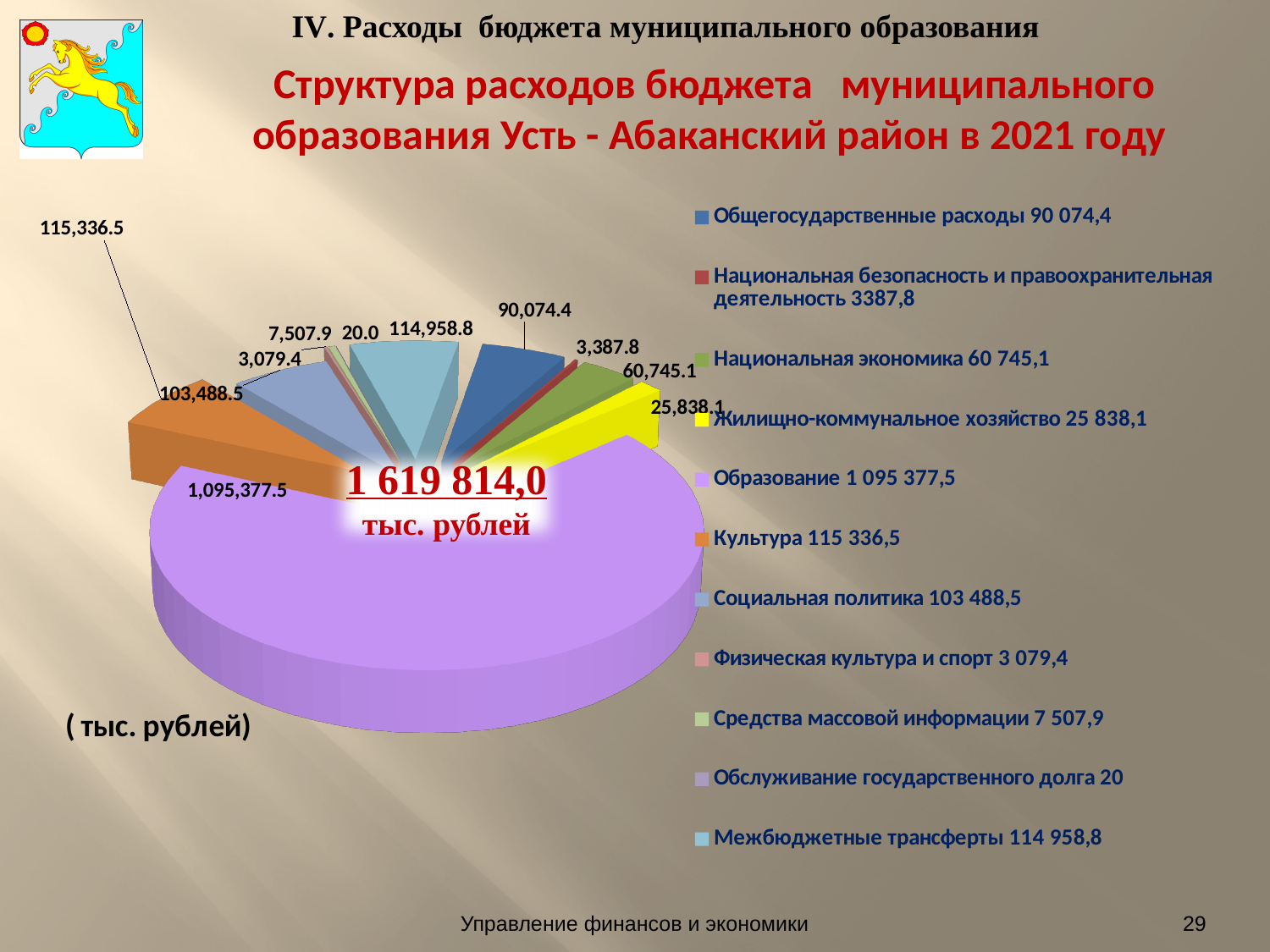
What type of chart is shown on the slide? Pie chart In what units are the values of the pie chart given, according to the slide? тыс. рублей Which is larger, the value for Национальная экономика or the value for Жилищно-коммунальное хозяйство? Национальная экономика Which category has the largest slice in the pie chart? Образование Which category has the smallest value in the pie chart? Обслуживание государственного долга What is the difference between the values for Культура and Социальная политика? 11,848.0 How many categories does the legend of the pie chart list? 11 What is the value for Образование in the pie chart? 1,095,377.5 What is the value for Межбюджетные трансферты in the pie chart? 114,958.8 What is the value for Обслуживание государственного долга in the pie chart? 20.0 What is the value for Общегосударственные расходы in the pie chart? 90,074.4 What total amount is printed in the centre of the pie chart? 1 619 814,0 тыс. рублей